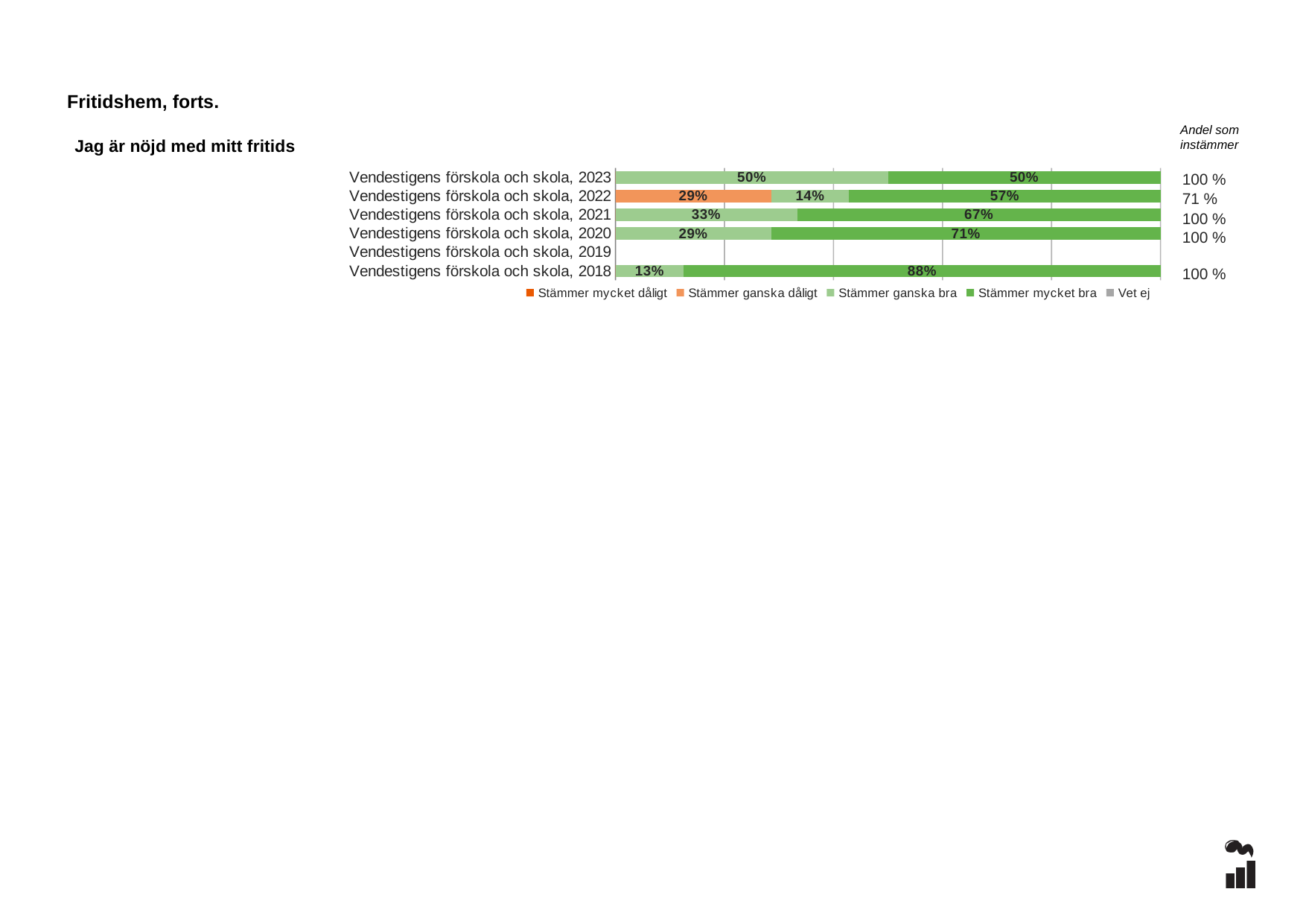
What is the value for 'Stämmer ganska bra' for Vendestigens förskola och skola, 2021? 33% What kind of chart is shown on the slide? stacked bar chart Which is larger: the 'Stämmer ganska bra' value for 2023 or for 2020? 2023 Which year row in the chart has no bar plotted? Vendestigens förskola och skola, 2019 Which year has the lowest 'Stämmer mycket bra' value? Vendestigens förskola och skola, 2023 What is the value for 'Stämmer ganska dåligt' for Vendestigens förskola och skola, 2022? 29% How many series does the legend list? 5 What is the title of the chart? Jag är nöjd med mitt fritids What is the value for 'Stämmer mycket bra' for Vendestigens förskola och skola, 2018? 88% What is the 'Andel som instämmer' value shown for Vendestigens förskola och skola, 2022? 71 % Which year has the highest 'Stämmer mycket bra' value? Vendestigens förskola och skola, 2018 What is the difference between the 'Stämmer mycket bra' values for 2020 and 2021? 4%